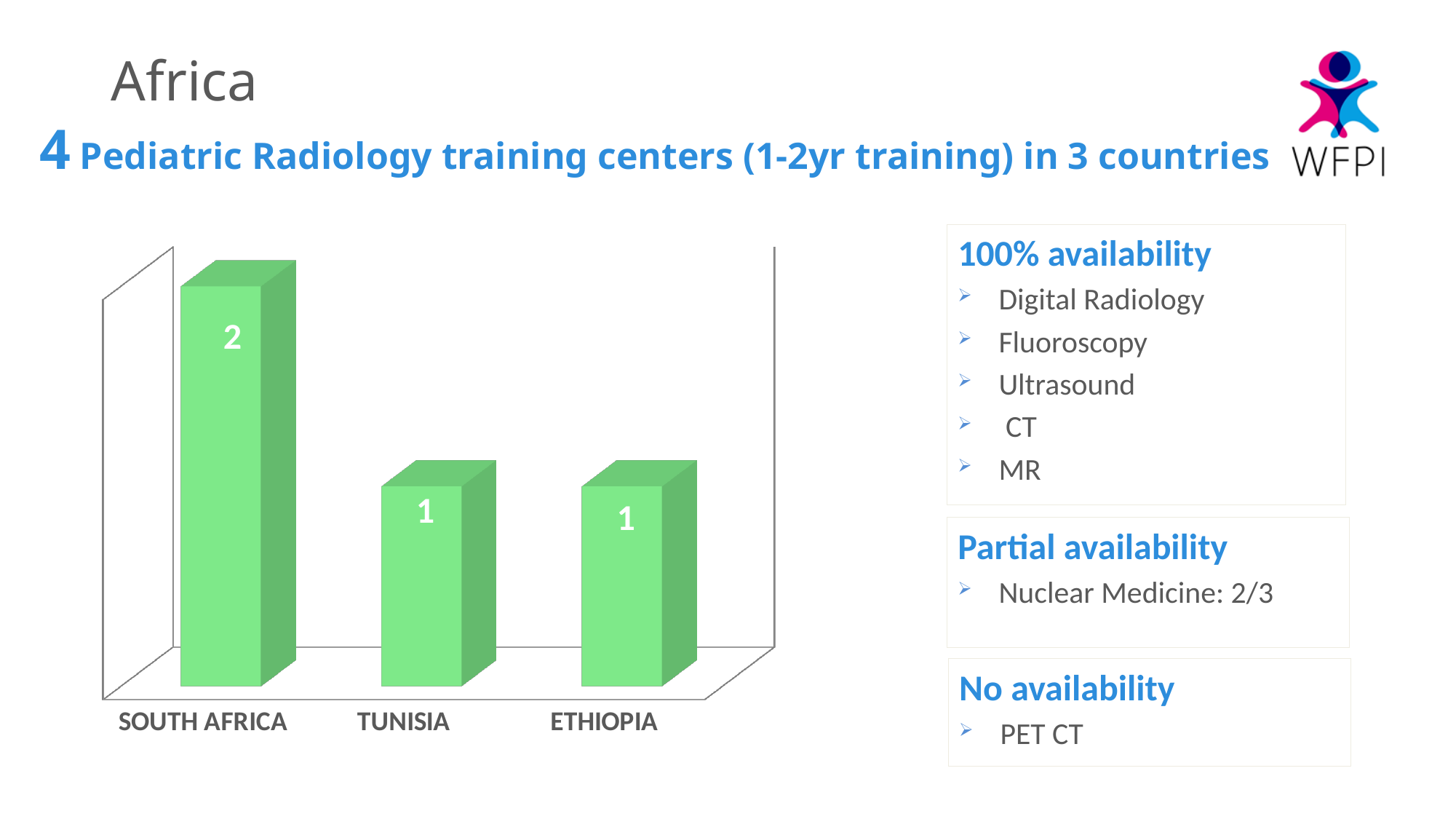
Do the values rise or fall from SOUTH AFRICA to TUNISIA? fall Which is larger, the value for SOUTH AFRICA or the value for ETHIOPIA? SOUTH AFRICA What kind of chart is shown on the slide? bar chart What is the value for SOUTH AFRICA? 2 Which country is shown first on the x axis? SOUTH AFRICA What is the value for TUNISIA? 1 Which country has the highest value? SOUTH AFRICA What is the value for ETHIOPIA? 1 What is the total of the values across all three countries? 4 What is the difference between the values for SOUTH AFRICA and TUNISIA? 1 How many countries are shown on the chart? 3 What colour are the bars on the chart? green